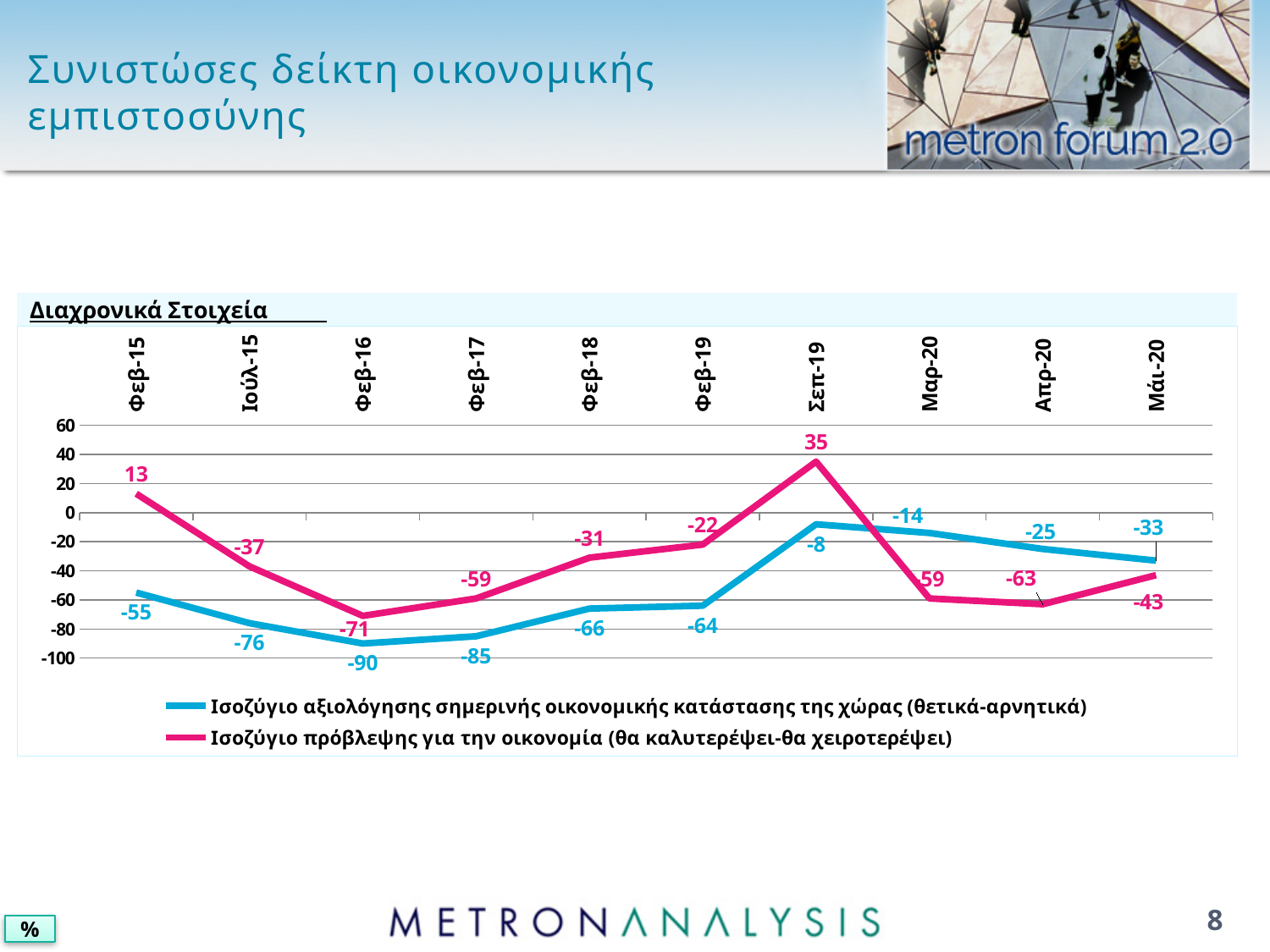
Does the blue series (Ισοζύγιο αξιολόγησης σημερινής οικονομικής κατάστασης) rise or fall from Φεβ-16 to Σεπ-19? rise What is the value of the pink series (Ισοζύγιο πρόβλεψης για την οικονομία) for Σεπ-19? 35 What type of chart is shown on the slide? line chart At which time point does the pink series (Ισοζύγιο πρόβλεψης για την οικονομία) reach its highest value? Σεπ-19 How many series does the legend list? 2 Which series has the higher value at Απρ-20, the blue series or the pink series? the blue series (Ισοζύγιο αξιολόγησης σημερινής οικονομικής κατάστασης) How many time points are plotted along the x axis? 10 At which time point does the blue series (Ισοζύγιο αξιολόγησης σημερινής οικονομικής κατάστασης) reach its lowest value? Φεβ-16 What is the value of the pink series (Ισοζύγιο πρόβλεψης για την οικονομία) for Φεβ-15? 13 What is the value of the blue series (Ισοζύγιο αξιολόγησης σημερινής οικονομικής κατάστασης) for Φεβ-16? -90 What is the value of the blue series (Ισοζύγιο αξιολόγησης σημερινής οικονομικής κατάστασης) for Μάι-20? -33 What is the difference between the pink series value and the blue series value at Σεπ-19? 43